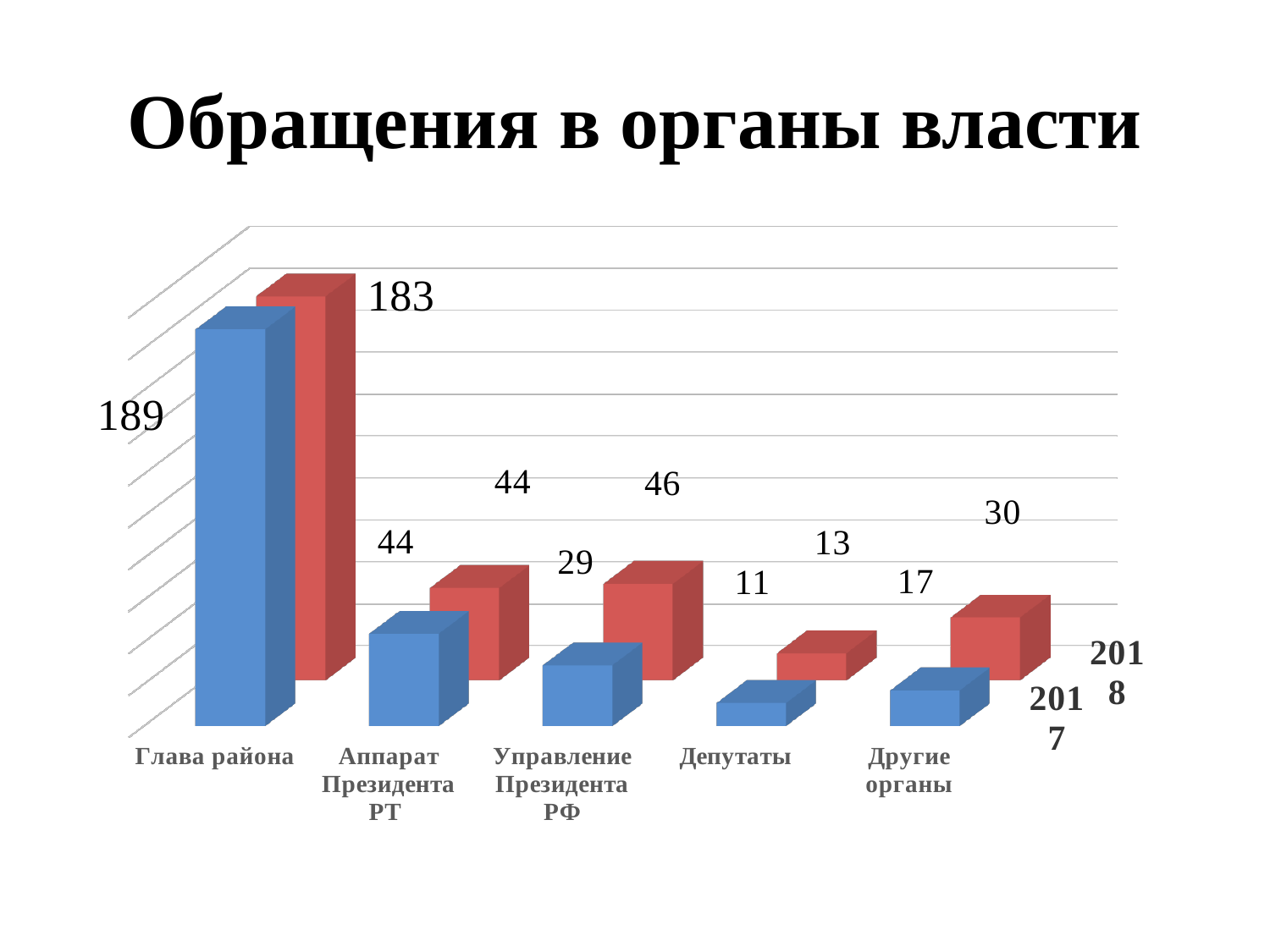
What is the value for Глава района in 2018? 183 How many data series does the chart show? 2 How many categories are shown on the x axis? 5 What type of chart is shown on the slide? Bar chart What is the value for Глава района in 2017? 189 Which category has the highest value in 2018? Глава района What is the value for Другие органы in 2017? 17 What is the difference between the 2018 and 2017 values for Управление Президента РФ? 17 What is the value for Управление Президента РФ in 2018? 46 What is the difference between the 2017 and 2018 values for Глава района? 6 Which is larger for Другие органы: the 2017 value or the 2018 value? 2018 Which category has the lowest value in 2017? Депутаты